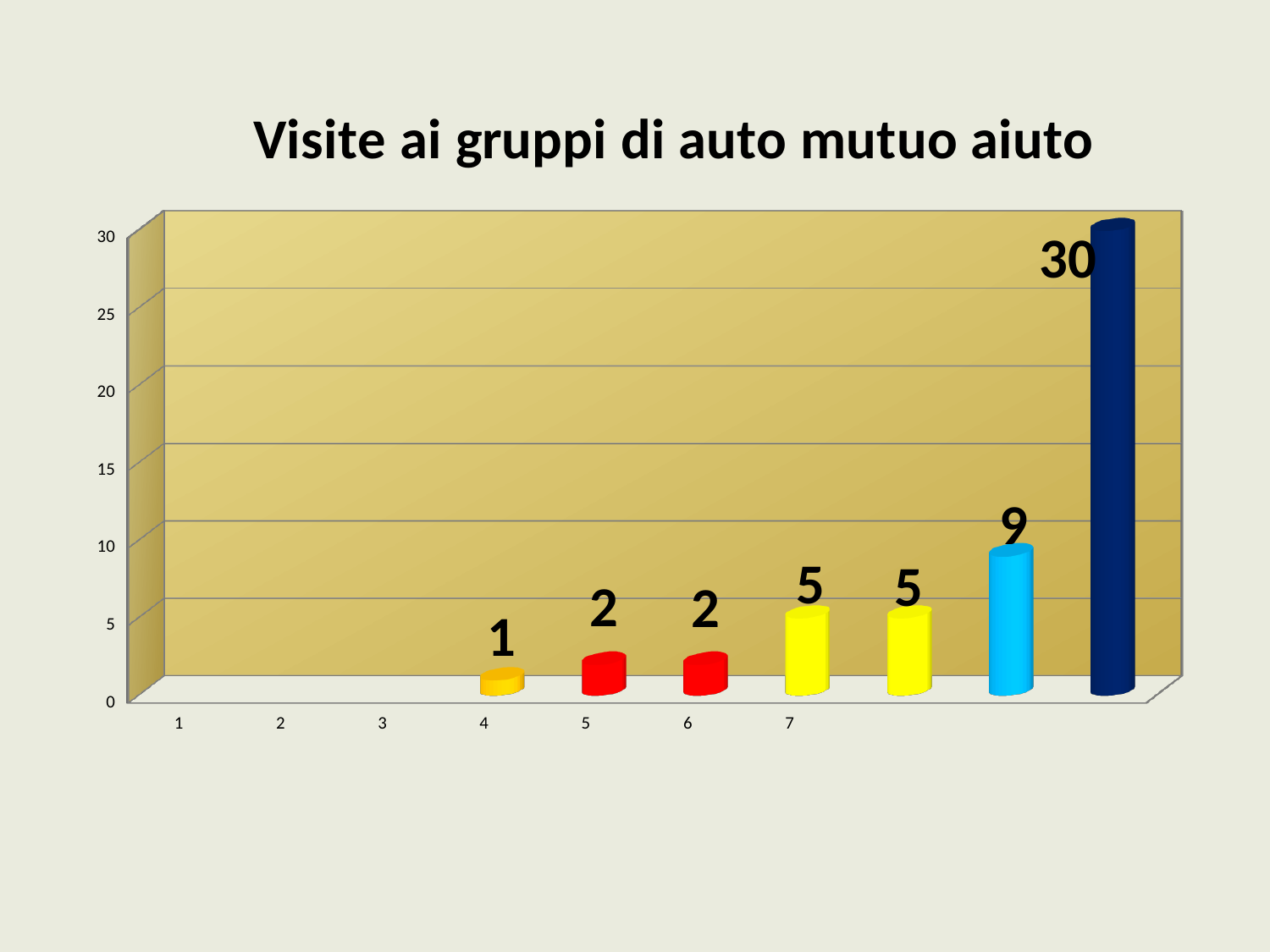
What value is labelled on the light blue bar? 9 Do the bar values rise or fall from left to right across the chart? rise What is the lowest value shown by any bar in the chart? 1 What value is labelled on the dark blue bar? 30 Which bar is taller, the light blue bar or the dark blue bar? the dark blue bar What is the highest value shown by any bar in the chart? 30 Is the value of the tallest bar greater or less than 25? greater What is the title of the chart? Visite ai gruppi di auto mutuo aiuto What value is labelled on the orange bar? 1 What is the difference between the tallest bar (30) and the shortest bar (1)? 29 How many bars are plotted in the chart? 7 What kind of chart is shown on the slide? bar chart